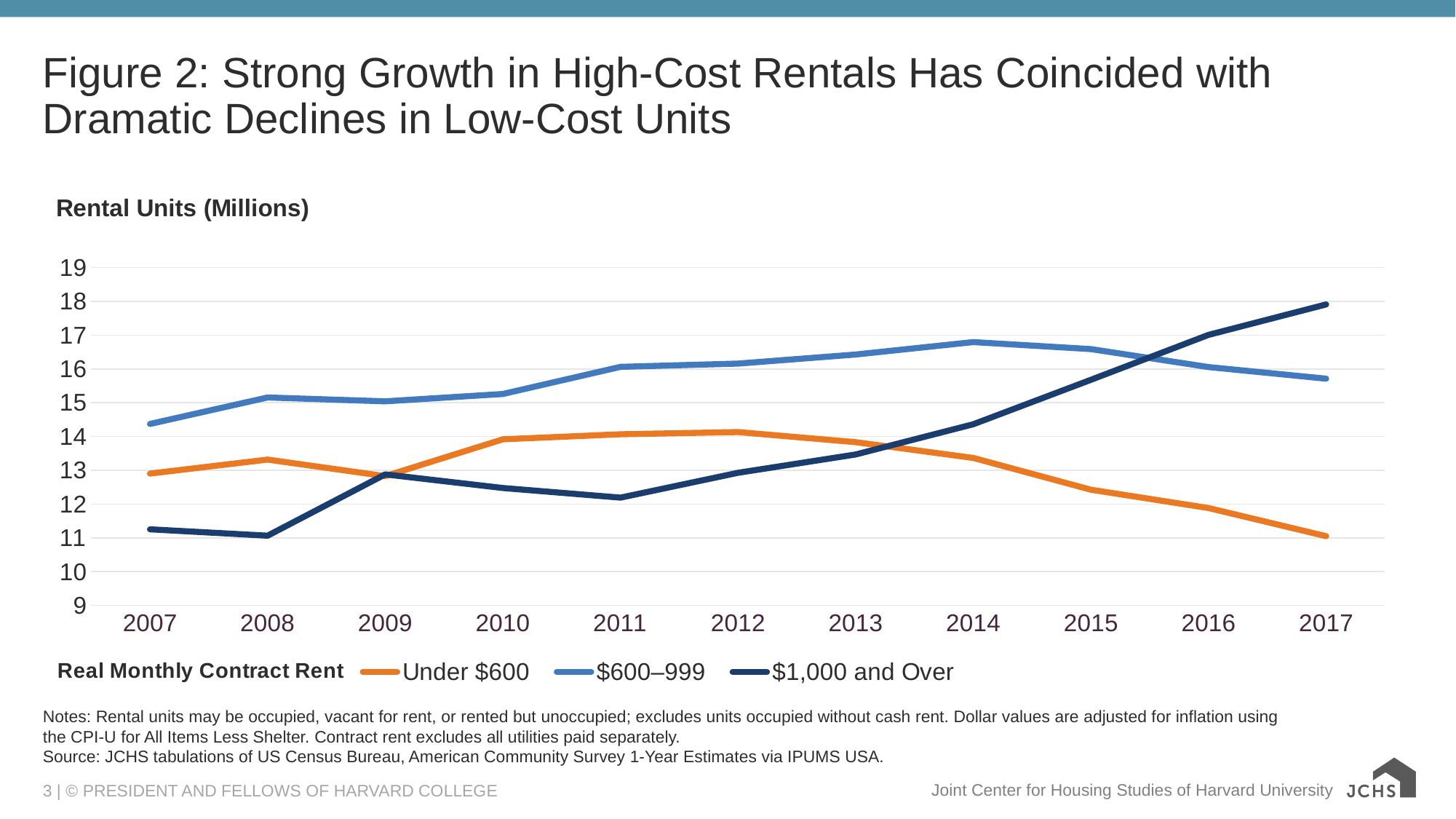
Does the $1,000 and Over line rise or fall from 2012 to 2017? rise In 2012, which is larger: the value for Under $600 or the value for $1,000 and Over? Under $600 How many years are shown on the x axis? 11 What type of chart is shown on the slide? line chart How many series does the legend list? 3 Is the value for $1,000 and Over in 2017 greater or less than 17? greater What is the label of the vertical axis? Rental Units (Millions) Is the value for $600–999 in 2014 greater or less than 16? greater Is the value for $1,000 and Over in 2008 greater or less than 12? less Which rent category has the highest number of rental units in 2017? $1,000 and Over Which rent category has the lowest number of rental units in 2007? $1,000 and Over